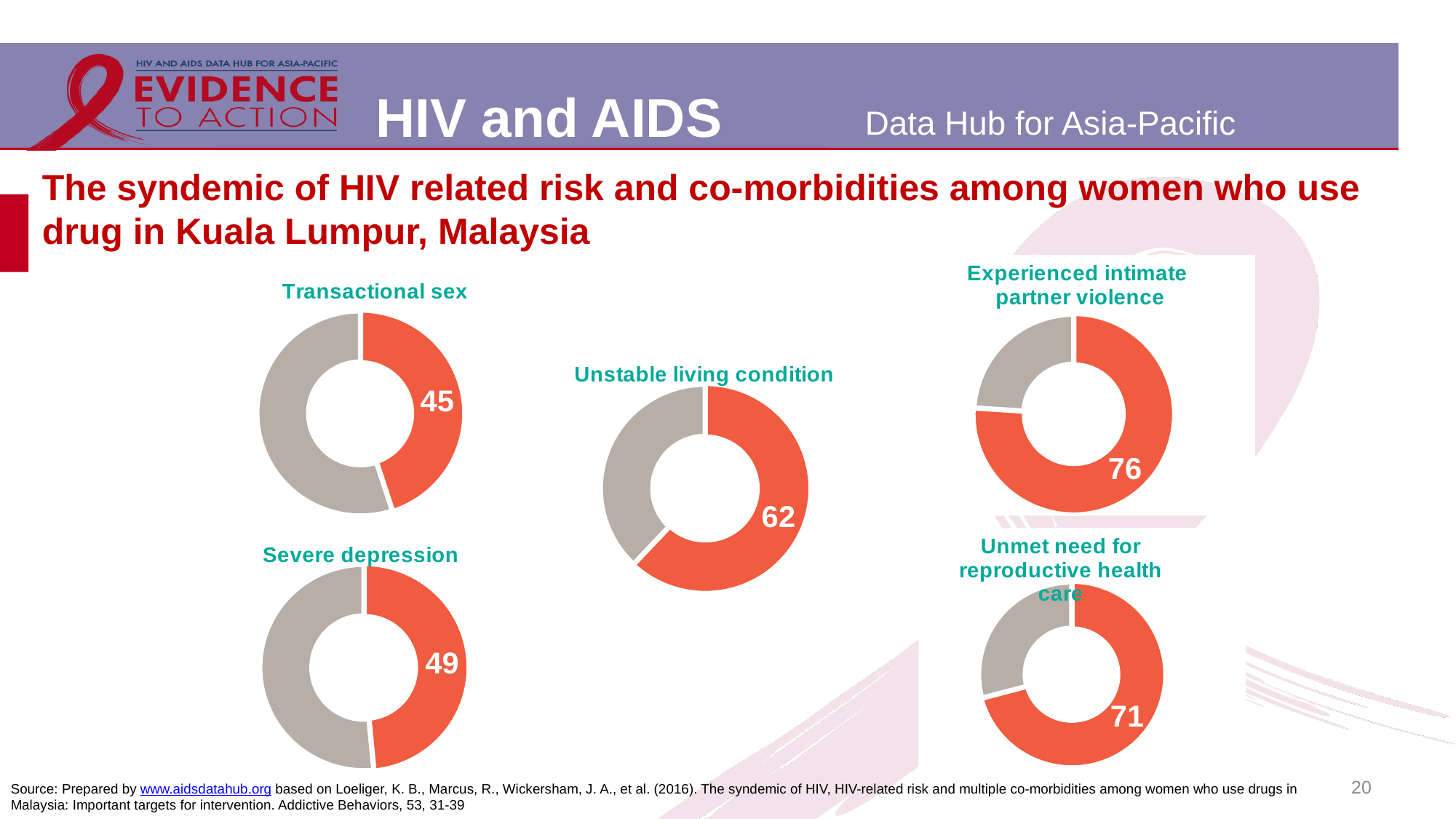
In the 'Experienced intimate partner violence' chart, what value is printed on the orange segment? 76 In the 'Transactional sex' chart, what value is printed on the orange segment? 45 In the 'Unmet need for reproductive health care' chart, what value is printed on the orange segment? 71 What kind of chart is used for 'Severe depression' on the slide? Donut (pie) chart Which is larger: the value in the 'Unstable living condition' chart or the value in the 'Severe depression' chart? Unstable living condition In the 'Severe depression' chart, what value is printed on the orange segment? 49 In the 'Unstable living condition' chart, what value is printed on the orange segment? 62 What is the difference between the value in the 'Unmet need for reproductive health care' chart and the value in the 'Unstable living condition' chart? 9 What is the difference between the value in the 'Experienced intimate partner violence' chart and the value in the 'Transactional sex' chart? 31 Across the five donut charts on the slide, which indicator has the highest printed value? Experienced intimate partner violence Across the five donut charts on the slide, which indicator has the lowest printed value? Transactional sex How many donut charts are shown on the slide? 5